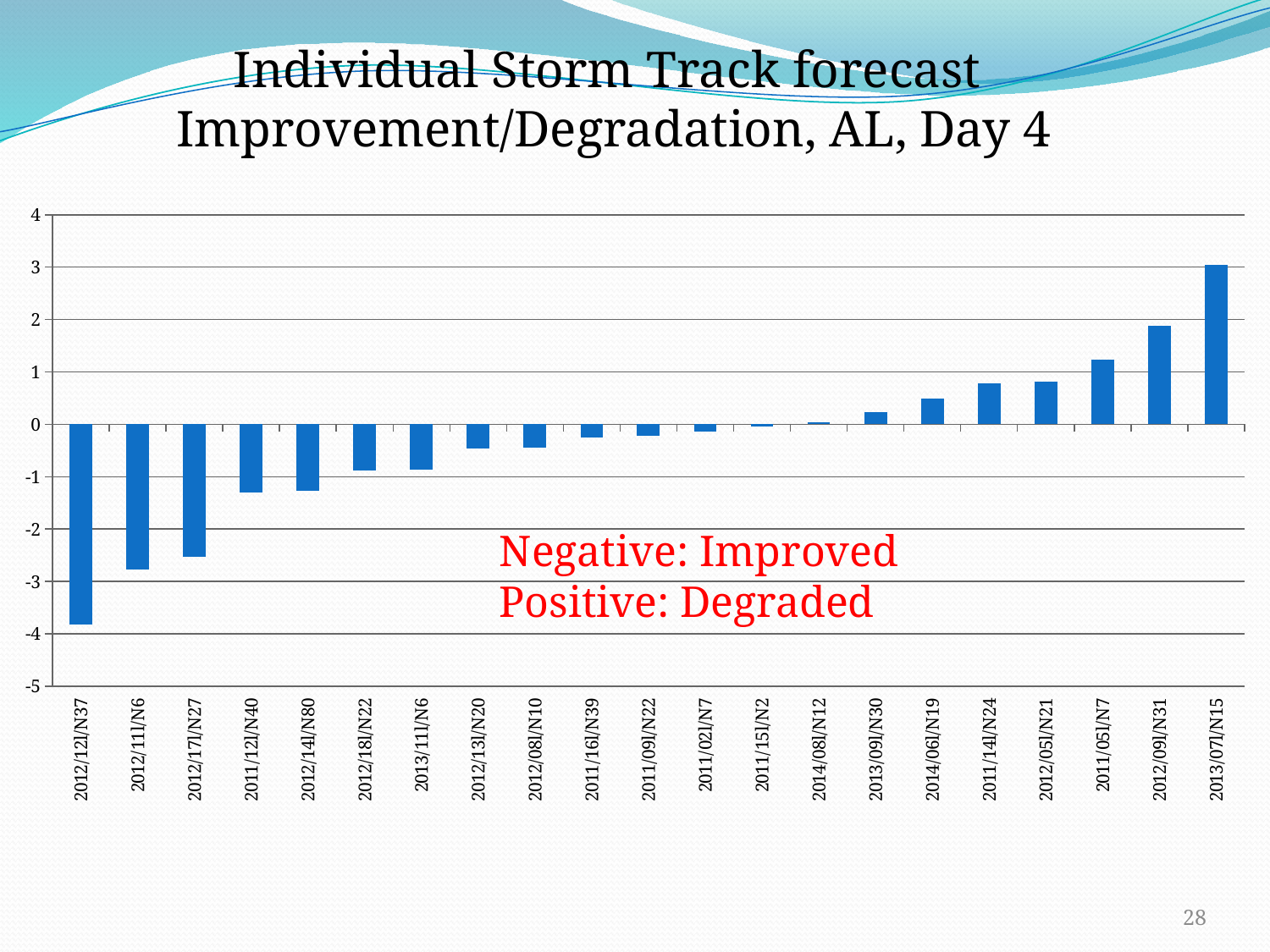
How many storm categories are plotted along the x axis? 21 According to the red annotation on the chart, what does a negative value indicate? Improved Do the values generally rise or fall moving from left to right along the x axis? rise What kind of chart is shown on the slide? bar chart Which storm has the lowest (most negative) value? 2012/12l/N37 Which storm has the highest (most positive) value? 2013/07l/N15 Is the value for 2011/12/N40 greater or less than -1? less Is the value for 2011/05/N7 greater or less than 1? greater Is the value for 2012/12/N37 greater or less than -3? less Which has the larger value, 2012/09/N31 or 2011/05/N7? 2012/09l/N31